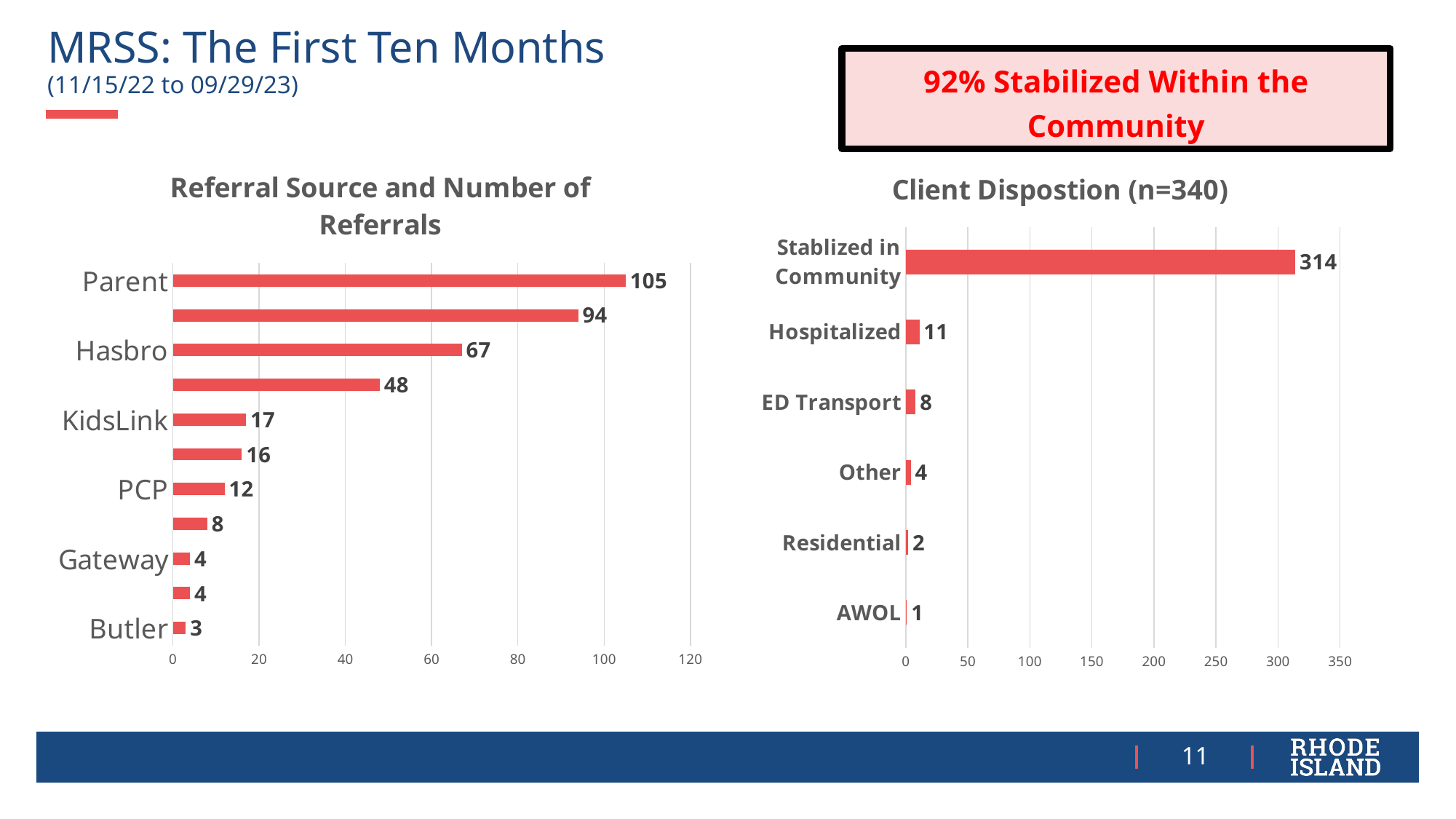
In the 'Referral Source and Number of Referrals' chart, how many referrals came from Parent? 105 In the 'Referral Source and Number of Referrals' chart, how many bars are plotted? 11 What type of chart is the 'Client Dispostion (n=340)' chart? Bar chart In the 'Client Dispostion (n=340)' chart, how many clients were Hospitalized? 11 In the 'Client Dispostion (n=340)' chart, which category has the lowest value? AWOL In the 'Referral Source and Number of Referrals' chart, how many referrals came from Hasbro? 67 In the 'Client Dispostion (n=340)' chart, how many clients were Stablized in Community? 314 In the 'Client Dispostion (n=340)' chart, how many categories are shown? 6 In the 'Referral Source and Number of Referrals' chart, which has more referrals, KidsLink or PCP? KidsLink In the 'Client Dispostion (n=340)' chart, what is the difference between Hospitalized and ED Transport? 3 In the 'Referral Source and Number of Referrals' chart, which labeled referral source has the lowest number of referrals? Butler In the 'Referral Source and Number of Referrals' chart, what is the difference between the Parent and Hasbro referral counts? 38